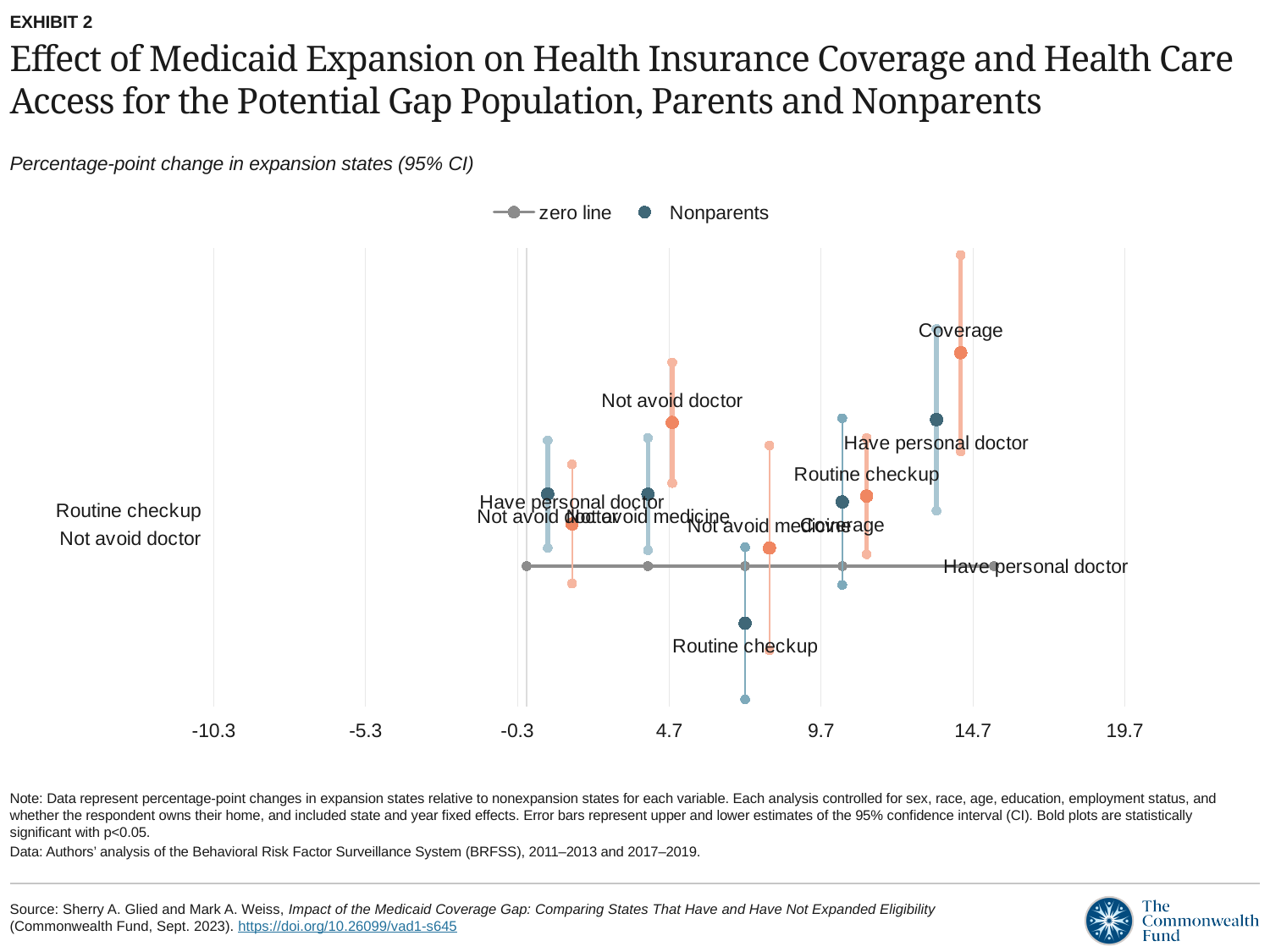
What is the lowest tick value shown on the x axis? -10.3 What are the two entries shown in the chart legend? zero line and Nonparents Is the dark blue Routine checkup point plotted below the zero line greater or less than 9.7? less What kind of chart is shown on the slide? Dot plot with error bars What is the highest tick value shown on the x axis? 19.7 Is the rightmost plotted point (the orange Coverage point) greater or less than 19.7? less What is the subtitle printed above the chart describing the measure plotted? Percentage-point change in expansion states (95% CI) How many tick labels are shown on the x axis? 7 Is the rightmost plotted point (the orange Coverage point) greater or less than 9.7? greater How many entries does the chart legend list? 2